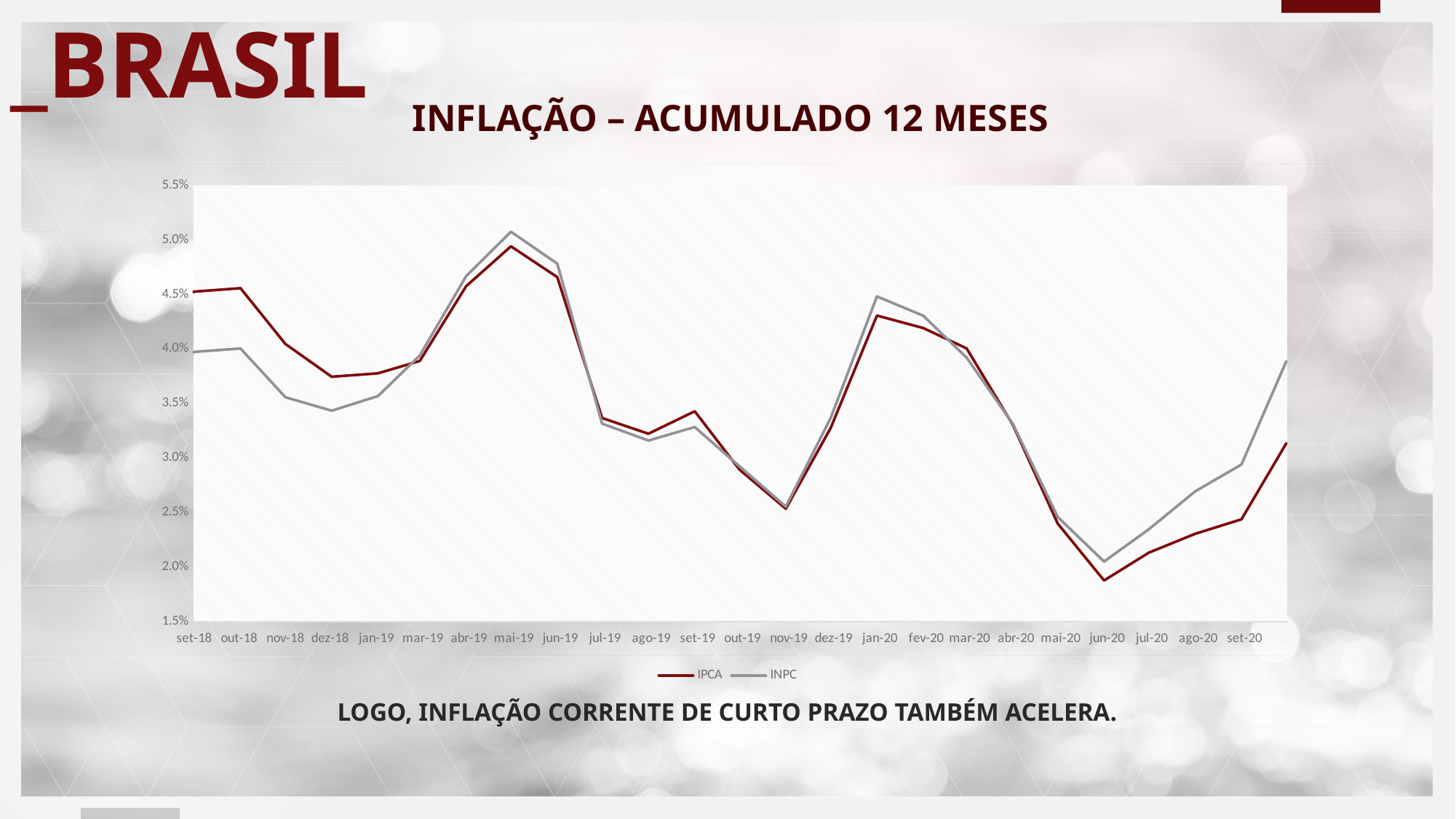
In which month does the INPC series reach its highest value? mai-19 Is the INPC value for mai-19 greater or less than 5.0%? greater What is the title of the chart? INFLAÇÃO – ACUMULADO 12 MESES In which month does the IPCA series reach its lowest value? jun-20 In which month does the IPCA series reach its highest value? mai-19 What kind of chart is shown on the slide? Line chart At set-20, which series has the higher value, IPCA or INPC? INPC Is the IPCA value for set-20 greater or less than 3.0%? greater At set-18, which series has the higher value, IPCA or INPC? IPCA How many month labels are shown on the x axis of the chart? 24 Is the IPCA value for jun-20 greater or less than 2.0%? less How many series does the chart legend list? 2